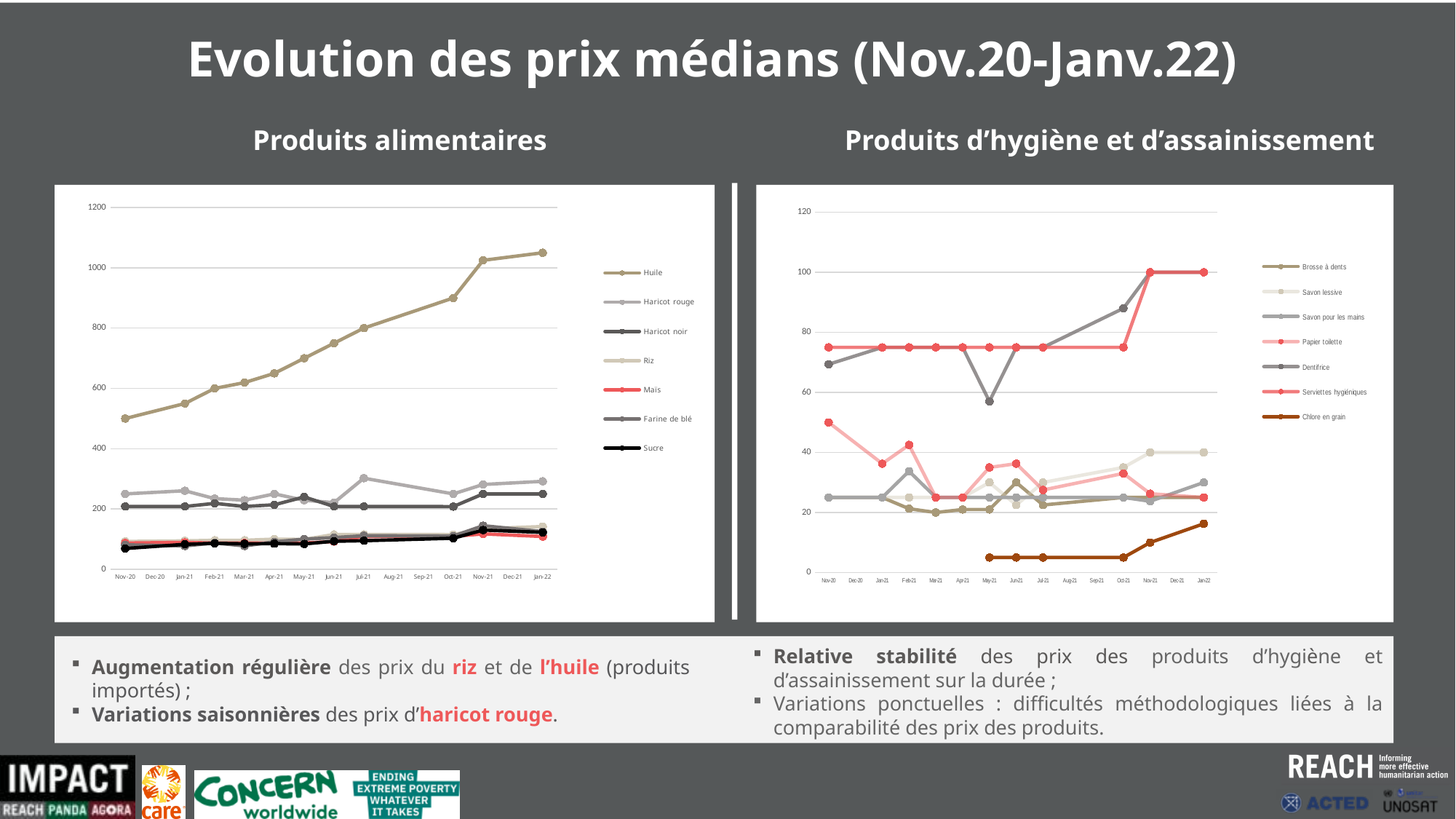
In the 'Produits d'hygiène et d'assainissement' chart, which series has the lowest values? Chlore en grain In the 'Produits alimentaires' chart, is the value for Huile at Nov-20 greater or less than 600? less In the 'Produits alimentaires' chart, which is larger at Jan-22, Huile or Sucre? Huile How many series does the legend of the 'Produits d'hygiène et d'assainissement' chart list? 7 In the 'Produits alimentaires' chart, does the Huile series rise or fall from Nov-20 to Jan-22? rise What kind of chart is the 'Produits alimentaires' chart? line chart In the 'Produits d'hygiène et d'assainissement' chart, is the value for Papier toilette at Nov-20 greater or less than 40? greater What is the heading above the left chart? Produits alimentaires In the 'Produits alimentaires' chart, is the value for Huile at Jan-22 greater or less than 1000? greater How many months are labelled on the x axis of the 'Produits alimentaires' chart? 15 How many series does the legend of the 'Produits alimentaires' chart list? 7 In the 'Produits alimentaires' chart, which series has the highest values? Huile